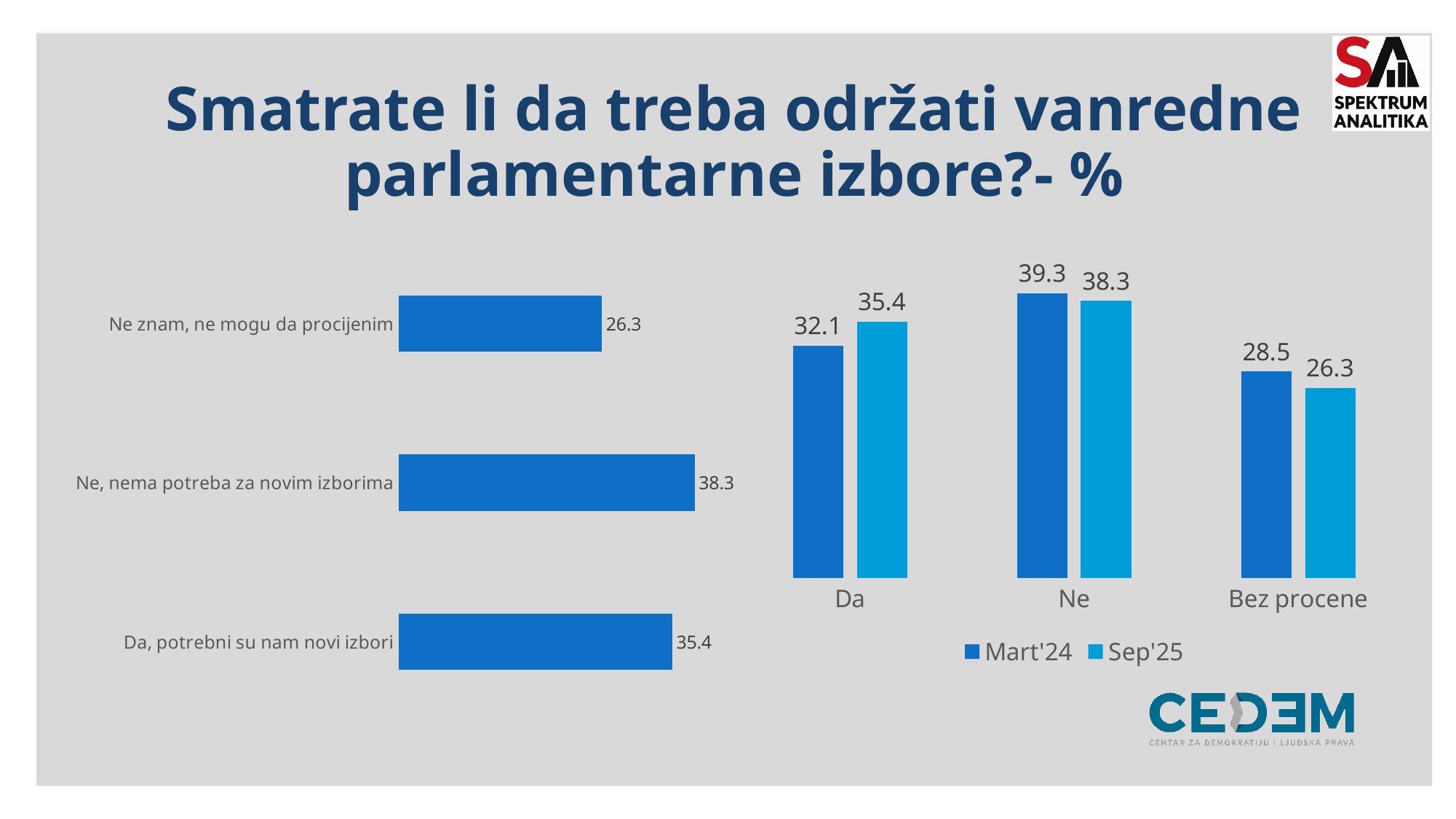
In the left chart, what is the value for "Da, potrebni su nam novi izbori"? 35.4 In the right chart, which category has the highest Sep'25 value? Ne In the left chart, what is the difference between the values for "Ne, nema potreba za novim izborima" and "Da, potrebni su nam novi izbori"? 2.9 In the right chart, which is larger for "Bez procene": the Mart'24 value or the Sep'25 value? Mart'24 In the right chart, what is the difference between the Sep'25 and Mart'24 values for "Da"? 3.3 In the left chart, how many categories are shown? 3 How many series does the legend of the right chart list? 2 In the right chart, what is the Mart'24 value for "Ne"? 39.3 In the left chart, what is the value for "Ne, nema potreba za novim izborima"? 38.3 What kind of chart is the right chart? Bar chart In the right chart, what is the Sep'25 value for "Bez procene"? 26.3 In the left chart, which category has the lowest value? Ne znam, ne mogu da procijenim